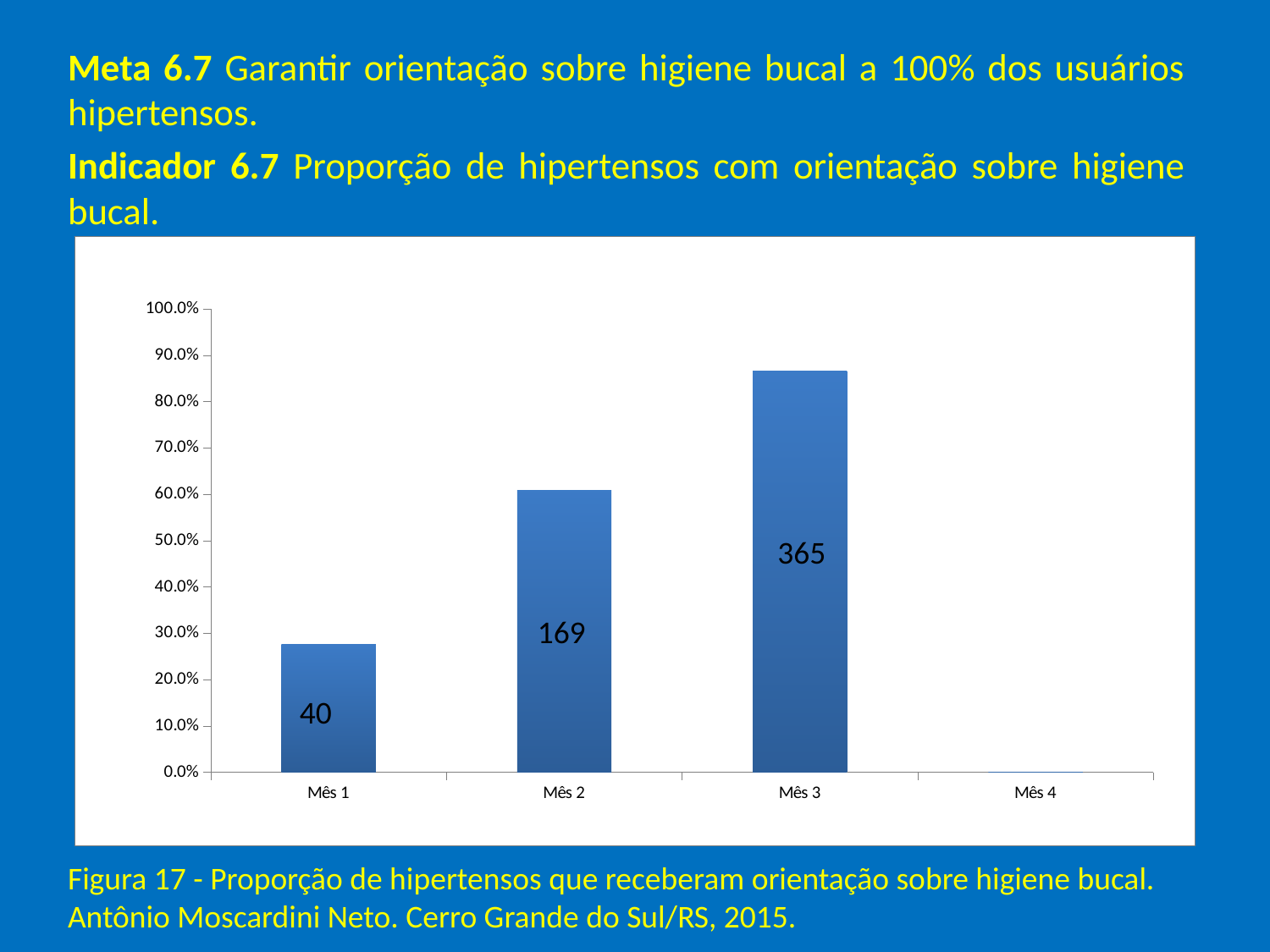
Is the bar for Mês 3 greater or less than 80.0%? greater What number is printed on the bar for Mês 1? 40 Is the bar for Mês 2 greater or less than 50.0%? greater Do the bar values rise or fall from Mês 1 to Mês 3? rise Which month has the shortest bar among Mês 1, Mês 2 and Mês 3? Mês 1 Which month has the tallest bar? Mês 3 How many categories are shown on the x axis of the chart? 4 What number is printed on the bar for Mês 3? 365 Is the bar for Mês 1 greater or less than 30.0%? less Which bar is taller, Mês 2 or Mês 3? Mês 3 What kind of chart is shown on the slide? bar chart What number is printed on the bar for Mês 2? 169